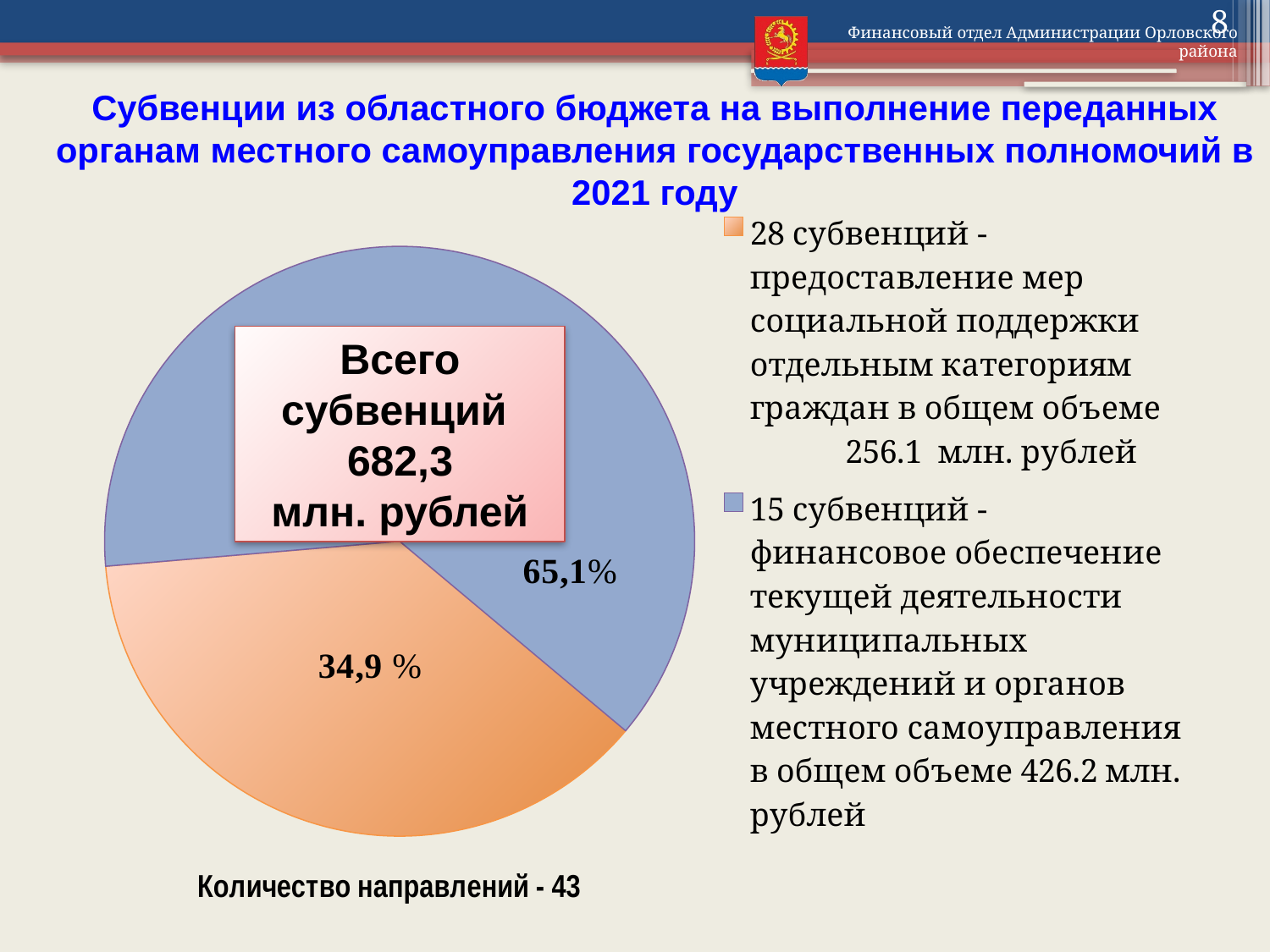
Is the share of the blue slice greater or less than 50%? greater Which category has the largest share of the pie? financial support of current activities of municipal institutions and local self-government bodies (65,1%) What number of directions (Количество направлений) is stated below the pie chart? 43 How many slices does the pie chart have? 2 What share of the pie is the orange slice (social support measures for certain categories of citizens)? 34,9 % Which slice of the pie is larger, the blue one or the orange one? the blue one What share of the pie is the blue slice (financial support of municipal institutions and local self-government bodies)? 65,1% What is the difference in percentage points between the blue slice and the orange slice? 30,2 What kind of chart is shown on the slide? pie chart What colour is the slice representing social support measures (28 subventions)? orange Which category has the smallest share of the pie? social support measures for certain categories of citizens (34,9 %) What total amount of subventions is shown in the box on the pie chart? 682,3 млн. рублей